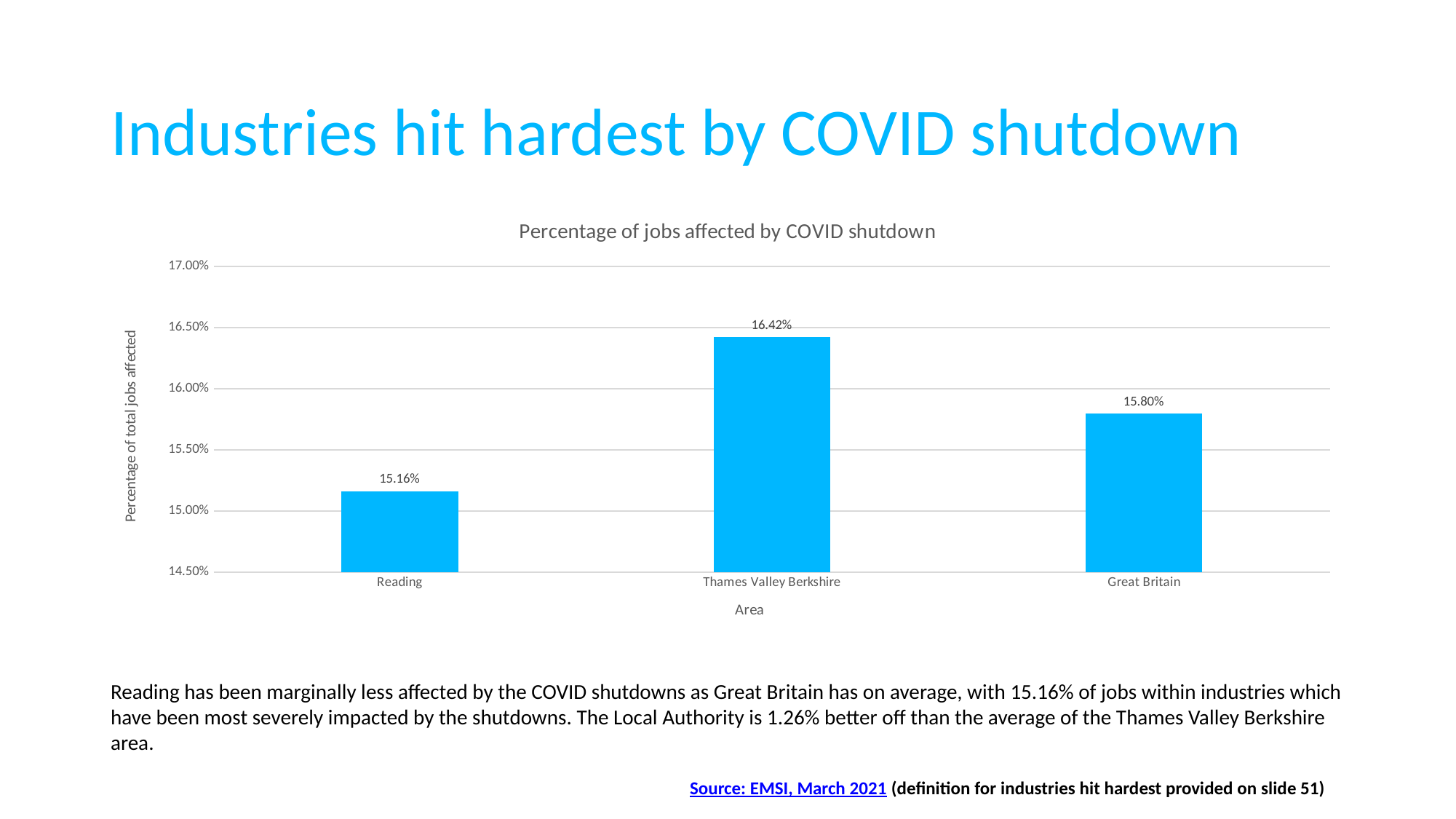
What is the difference between the values for Great Britain and Reading? 0.64% What is the value for Great Britain? 15.80% Which area has the highest percentage of jobs affected by COVID shutdown? Thames Valley Berkshire How many areas are shown on the chart? 3 Which is larger, the value for Great Britain or the value for Reading? Great Britain What is the title of the chart? Percentage of jobs affected by COVID shutdown Which area has the lowest percentage of jobs affected by COVID shutdown? Reading What is the value for Thames Valley Berkshire? 16.42% What kind of chart is shown on the slide? Bar chart Is the value for Thames Valley Berkshire greater or less than 16.00%? greater What is the value for Reading? 15.16% What is the difference between the values for Thames Valley Berkshire and Reading? 1.26%